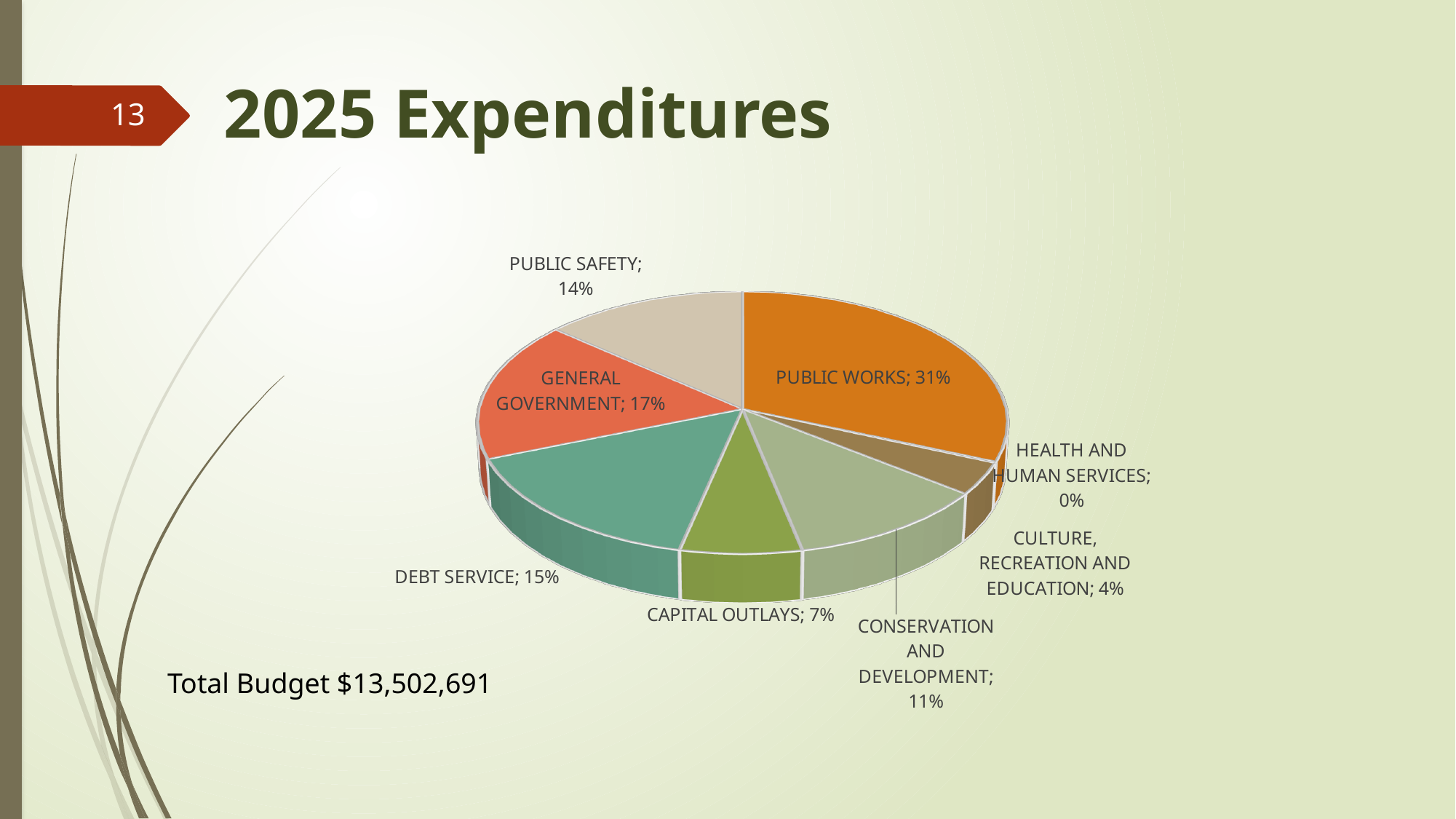
What kind of chart is shown on the slide? Pie chart Which is larger, Debt Service or Culture, Recreation and Education? Debt Service Which category has the smallest share of expenditures? Health and Human Services What is the title of the slide containing the chart? 2025 Expenditures Which category has the largest share of expenditures? Public Works What percentage is shown for Capital Outlays? 7% How many categories are shown in the pie chart? 8 What is the difference in percentage points between Public Works and Debt Service? 16 What share of 2025 expenditures goes to Public Works? 31% What is the difference in percentage points between General Government and Public Safety? 3 What percentage of expenditures is Debt Service? 15% What percentage is shown for Conservation and Development? 11%